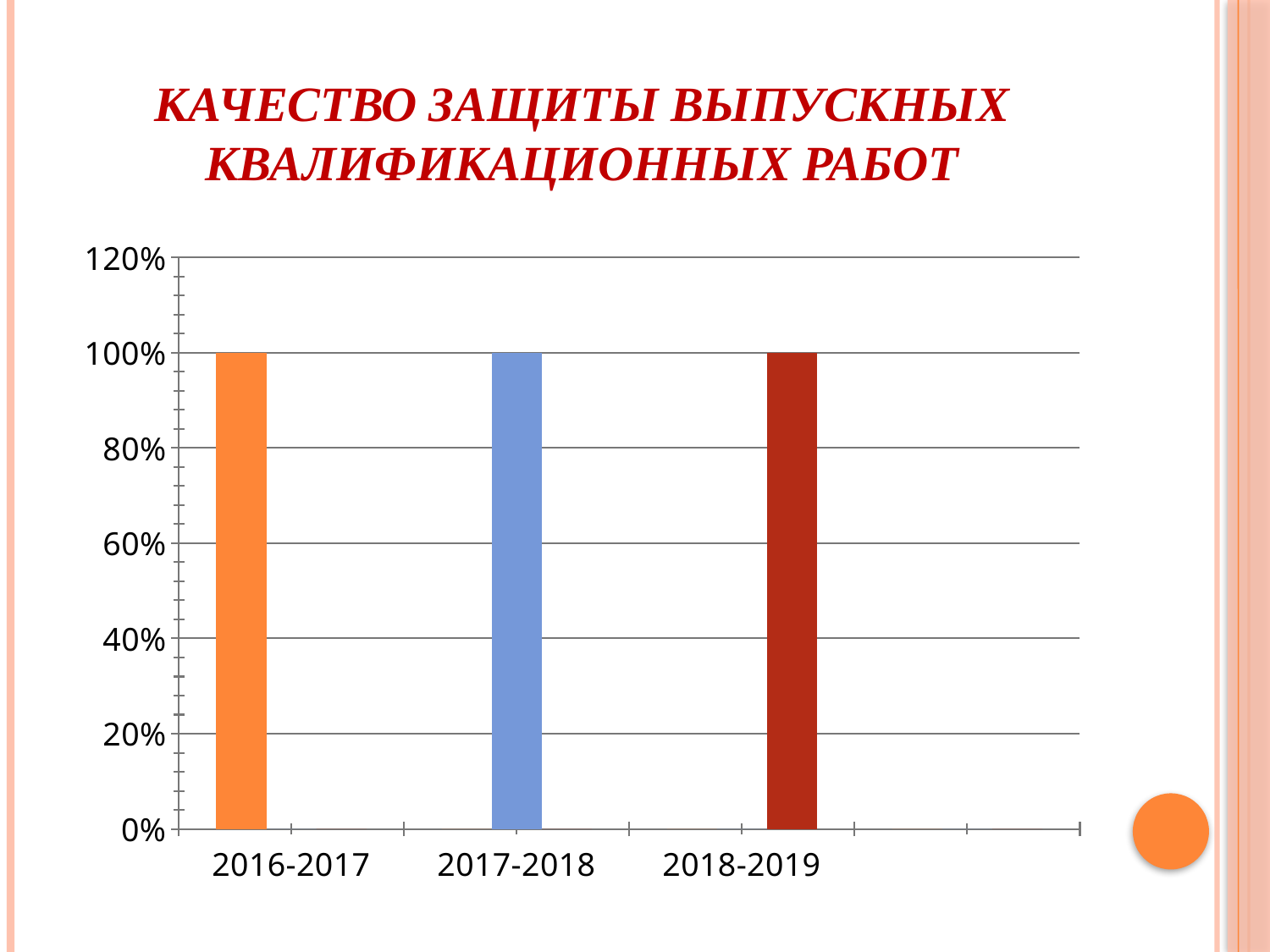
Is the value for 2017-2018 greater or less than 80%? greater What is the value for 2017-2018? 100% What kind of chart is shown on the slide? bar chart How many categories are shown on the x axis? 3 Is the value for 2018-2019 greater or less than 120%? less What is the difference between the values for 2016-2017 and 2018-2019? 0% Do the values rise, fall, or stay the same from 2016-2017 to 2018-2019? stay the same What is the value for 2018-2019? 100% What is the highest value shown on the y axis? 120% What is the value for 2016-2017? 100% What colour is the bar for 2017-2018? blue